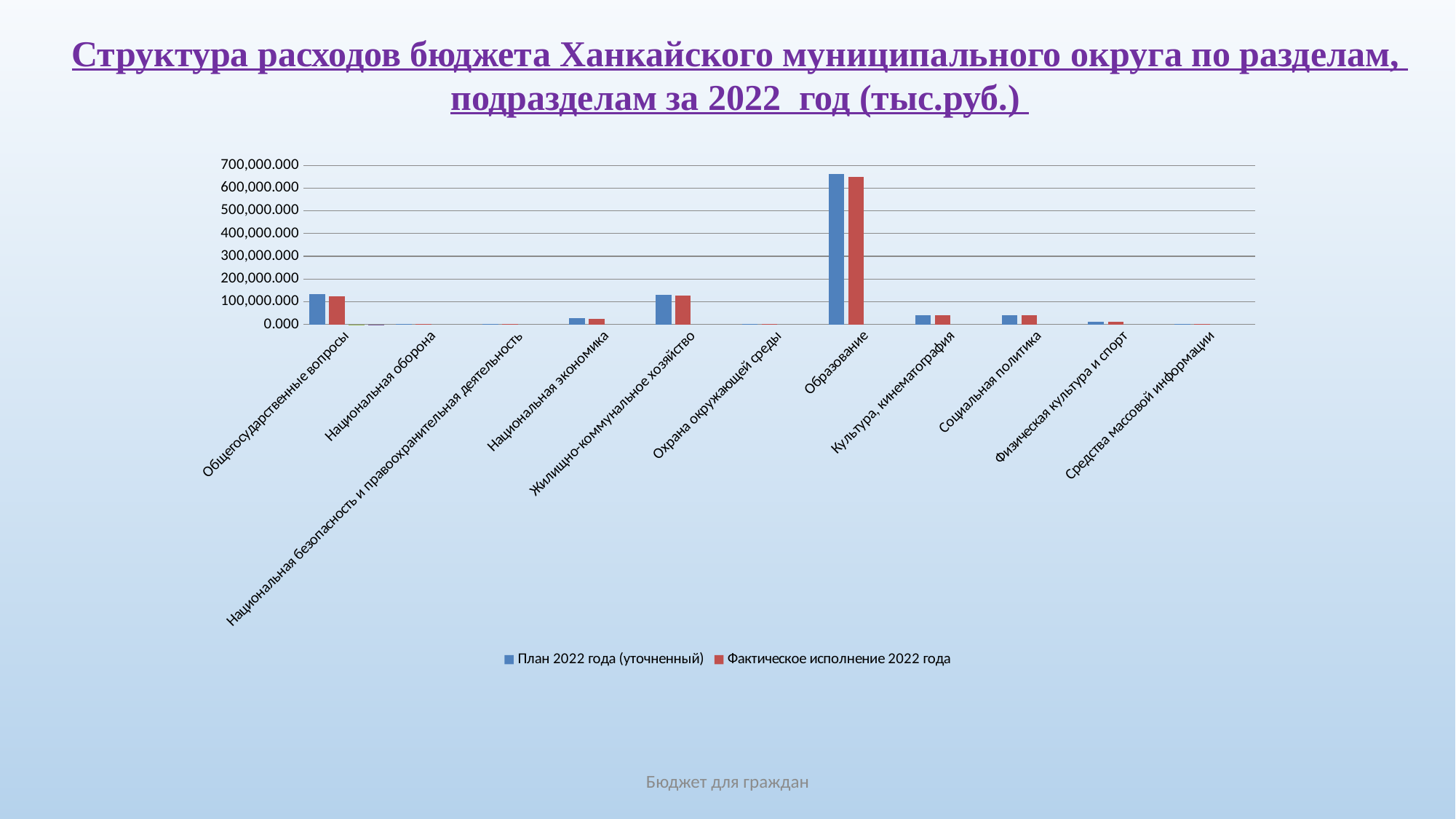
What kind of chart is shown on the slide? bar chart Which category has the highest value for План 2022 года (уточненный)? Образование What is the highest value shown on the chart's vertical axis? 700,000.000 Is the value for Образование in the series План 2022 года (уточненный) greater or less than 600,000.000? greater Is the value for Общегосударственные вопросы in the series План 2022 года (уточненный) greater or less than 100,000.000? greater What are the two series named in the chart legend? План 2022 года (уточненный) and Фактическое исполнение 2022 года Is the value for Национальная экономика in the series Фактическое исполнение 2022 года greater or less than 100,000.000? less Which is larger for Фактическое исполнение 2022 года: Образование or Общегосударственные вопросы? Образование How many categories are shown along the x axis of the chart? 11 Which is larger for План 2022 года (уточненный): Жилищно-коммунальное хозяйство or Национальная экономика? Жилищно-коммунальное хозяйство How many series does the chart legend list? 2